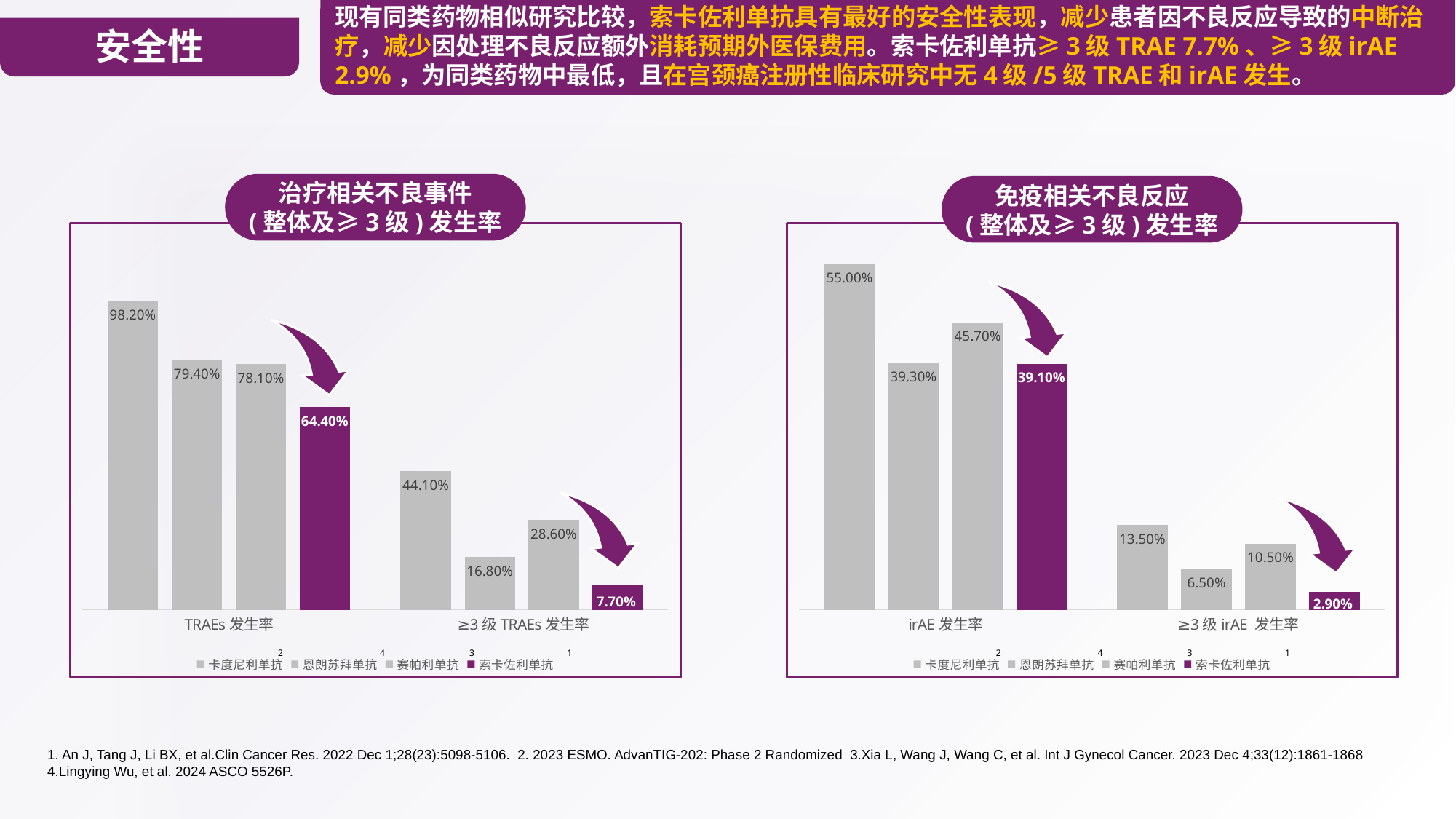
In the left chart (治疗相关不良事件), what is the TRAEs 发生率 for 索卡佐利单抗? 64.40% In the right chart (免疫相关不良反应), what is the ≥3 级 irAE 发生率 for 索卡佐利单抗? 2.90% In the left chart (治疗相关不良事件), which drug has the highest TRAEs 发生率? 卡度尼利单抗 In the left chart (治疗相关不良事件), what is the ≥3 级 TRAEs 发生率 for 卡度尼利单抗? 44.10% In the right chart (免疫相关不良反应), what is the irAE 发生率 for 赛帕利单抗? 45.70% What type of chart is the left chart (治疗相关不良事件)? Bar chart In the right chart (免疫相关不良反应), which drug has the highest irAE 发生率? 卡度尼利单抗 In the left chart (治疗相关不良事件), which is larger: the ≥3 级 TRAEs 发生率 for 赛帕利单抗 or for 恩朗苏拜单抗? 赛帕利单抗 In the left chart (治疗相关不良事件), what is the difference between the TRAEs 发生率 of 卡度尼利单抗 and 索卡佐利单抗? 33.80% How many series does the legend of the right chart (免疫相关不良反应) list? 4 In the left chart (治疗相关不良事件), which drug has the lowest ≥3 级 TRAEs 发生率? 索卡佐利单抗 In the right chart (免疫相关不良反应), what is the difference between the ≥3 级 irAE 发生率 of 卡度尼利单抗 and 恩朗苏拜单抗? 7.00%